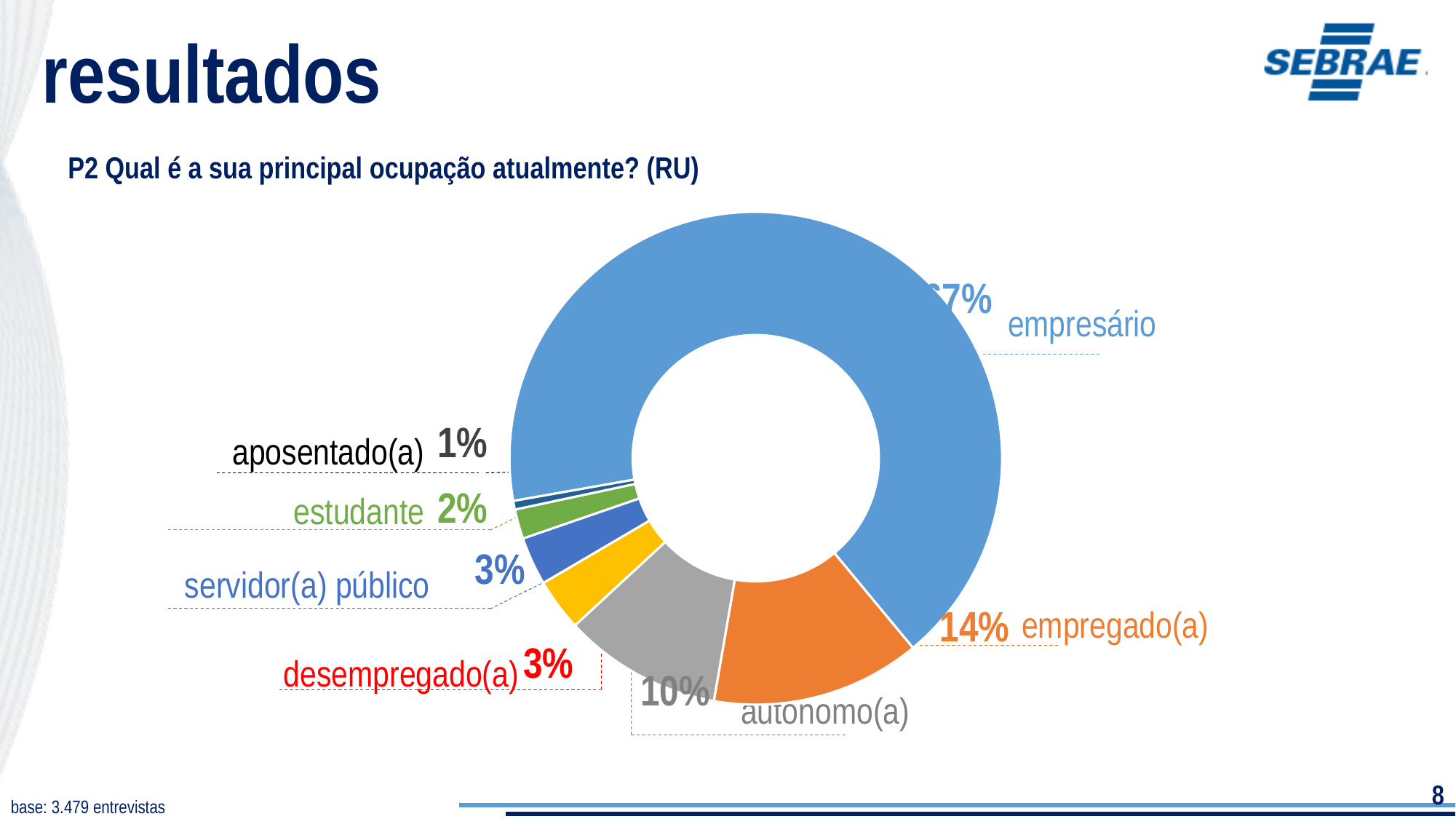
What percentage is shown for servidor(a) público? 3% What percentage is shown for aposentado(a)? 1% What percentage is shown for estudante? 2% Which occupation has the smallest share? aposentado(a) Which is larger, the share for estudante or for aposentado(a)? estudante What percentage of respondents are empregado(a)? 14% What share of respondents are autônomo(a)? 10% Which occupation has the largest slice of the chart? empresário How many occupation categories are shown in the chart? 7 What type of chart is used on this slide? donut chart What percentage of respondents are desempregado(a)? 3% How many percentage points higher is empregado(a) than autônomo(a)? 4 percentage points